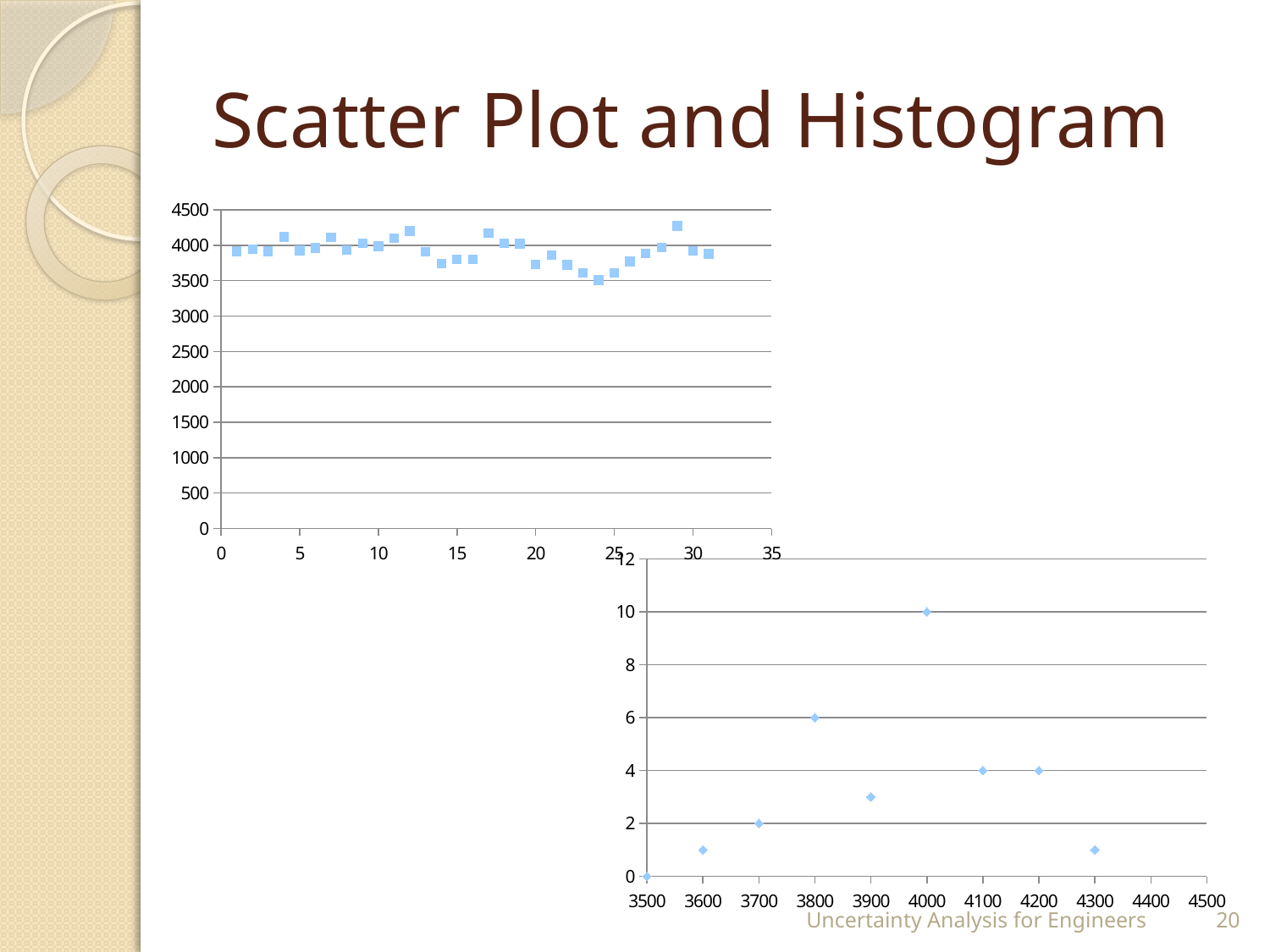
In the top-left chart, is the value at x = 24 greater or less than 4000? less In the bottom-right chart, what is the value at x = 3800? 6 In the bottom-right chart, which x value has the highest point? 4000 What is the title of the slide? Scatter Plot and Histogram In the bottom-right chart, which x value has the lowest point? 3500 In the bottom-right chart, which is larger, the value at x = 3700 or the value at x = 3900? 3900 How many data points are plotted in the bottom-right chart? 9 In the top-left chart, is the value at x = 29 greater or less than 4000? greater In the bottom-right chart, what is the difference between the values at x = 4000 and x = 3800? 4 What kind of chart is the top-left chart? scatter plot In the bottom-right chart, what is the value at x = 4000? 10